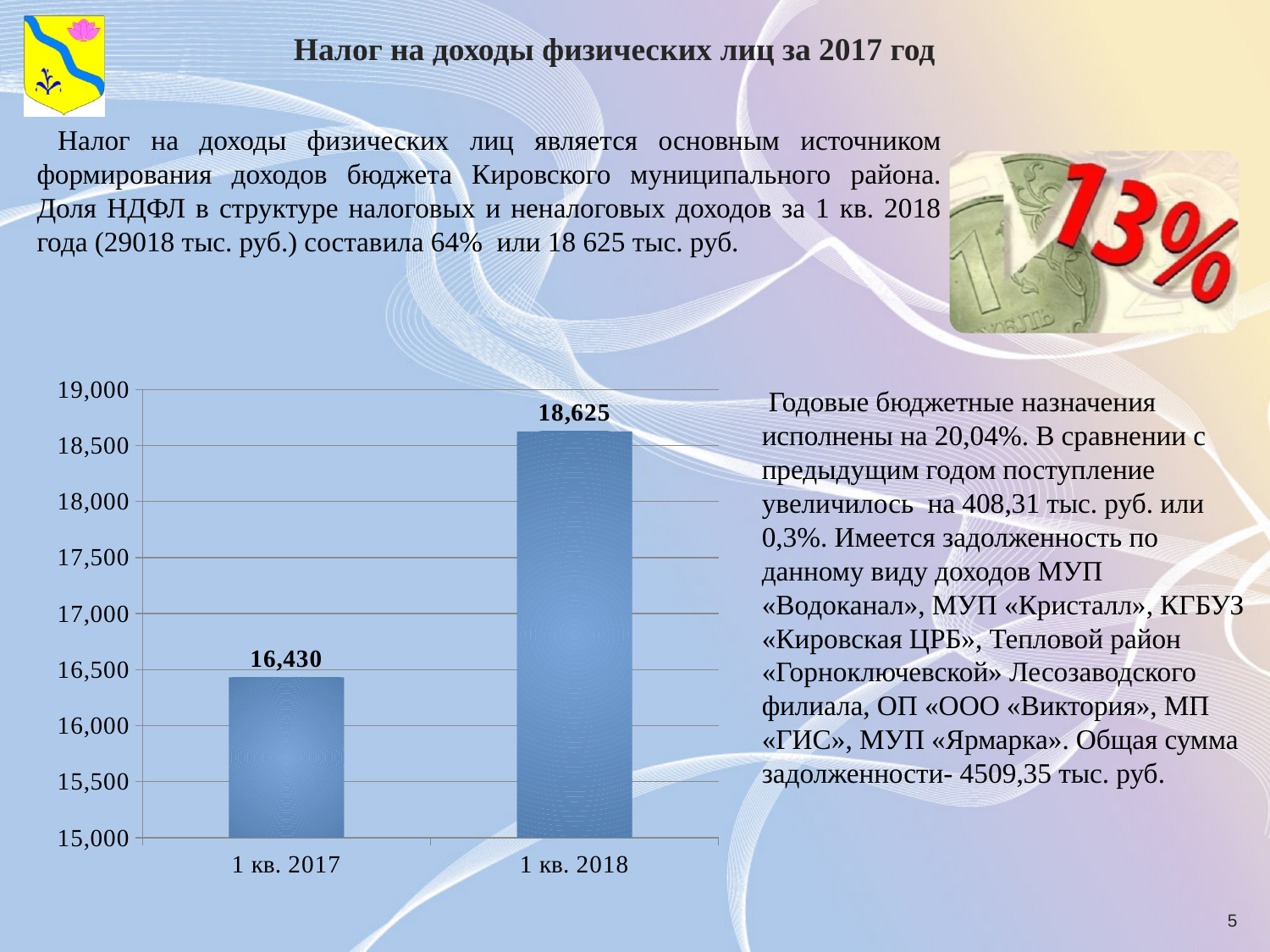
What is the lowest value shown on the chart's vertical axis? 15,000 Do the values rise or fall from 1 кв. 2017 to 1 кв. 2018? rise Is the value for 1 кв. 2017 greater or less than 17,000? less What is the difference between the values for 1 кв. 2018 and 1 кв. 2017? 2,195 What is the value for 1 кв. 2017? 16,430 Which category has the lowest value? 1 кв. 2017 What kind of chart is shown on the slide? bar chart How many categories are shown on the chart? 2 Is the value for 1 кв. 2018 greater or less than 18,000? greater What is the value for 1 кв. 2018? 18,625 Which is larger, the value for 1 кв. 2017 or the value for 1 кв. 2018? 1 кв. 2018 Which category has the highest value? 1 кв. 2018